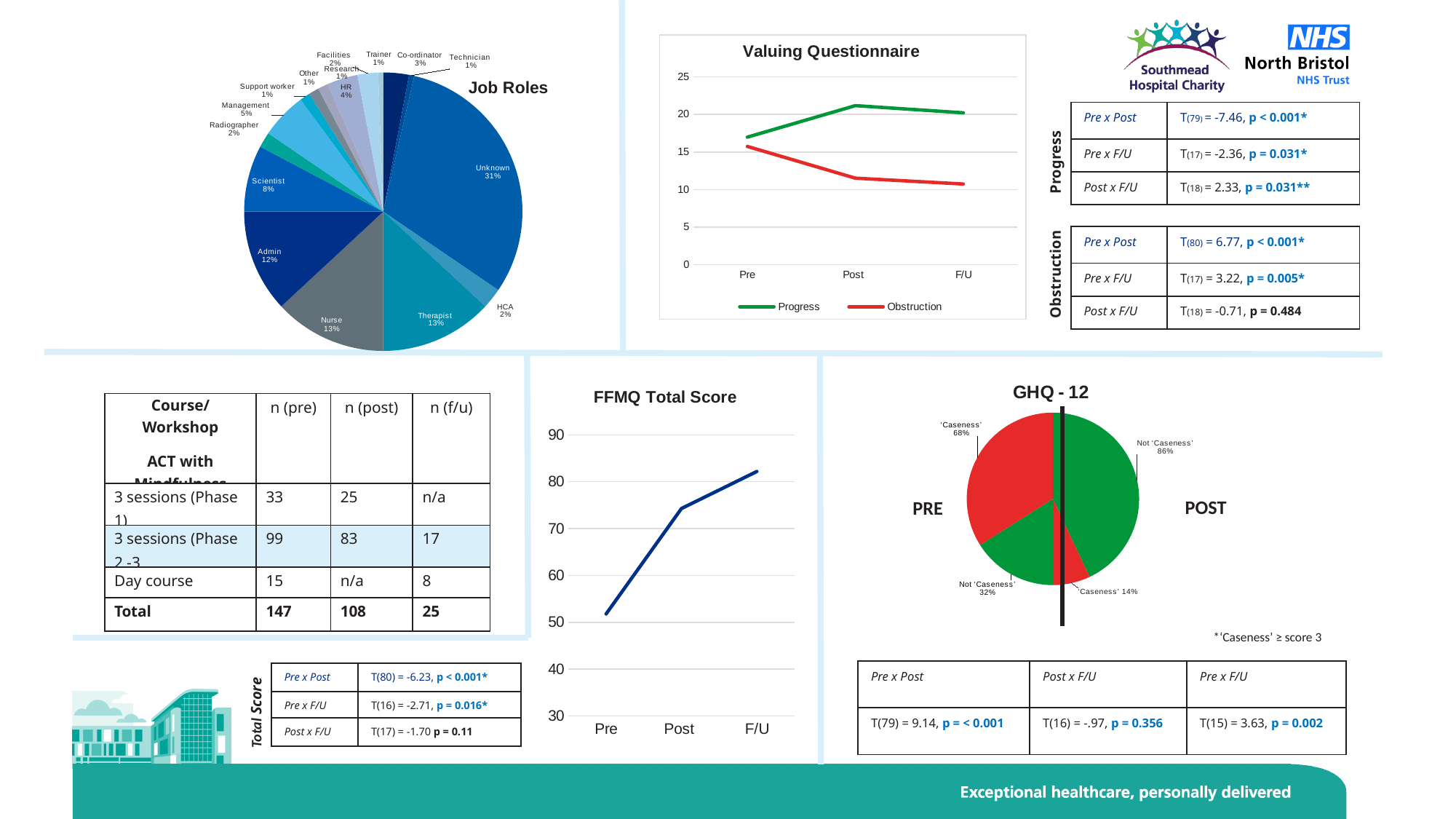
In the Job Roles pie chart, which job role has the largest slice? Unknown In the GHQ - 12 PRE pie chart, what percentage is labelled 'Caseness'? 68% In the Job Roles pie chart, what percentage is labelled for Admin? 12% In the FFMQ Total Score chart, is the value at Post greater or less than 70? greater In the Job Roles pie chart, what percentage is labelled for Unknown? 31% In the Job Roles pie chart, which is larger, the Nurse slice or the Scientist slice? Nurse How many series does the legend of the Valuing Questionnaire chart list? 2 In the GHQ - 12 POST pie chart, what percentage is labelled Not 'Caseness'? 86% In the Job Roles pie chart, what is the difference in percentage points between Scientist and Management? 3 In the Valuing Questionnaire chart, is the Progress value at Post greater or less than 20? greater In the Valuing Questionnaire chart, does the Obstruction line rise or fall from Pre to F/U? fall What kind of chart is the FFMQ Total Score chart? line chart